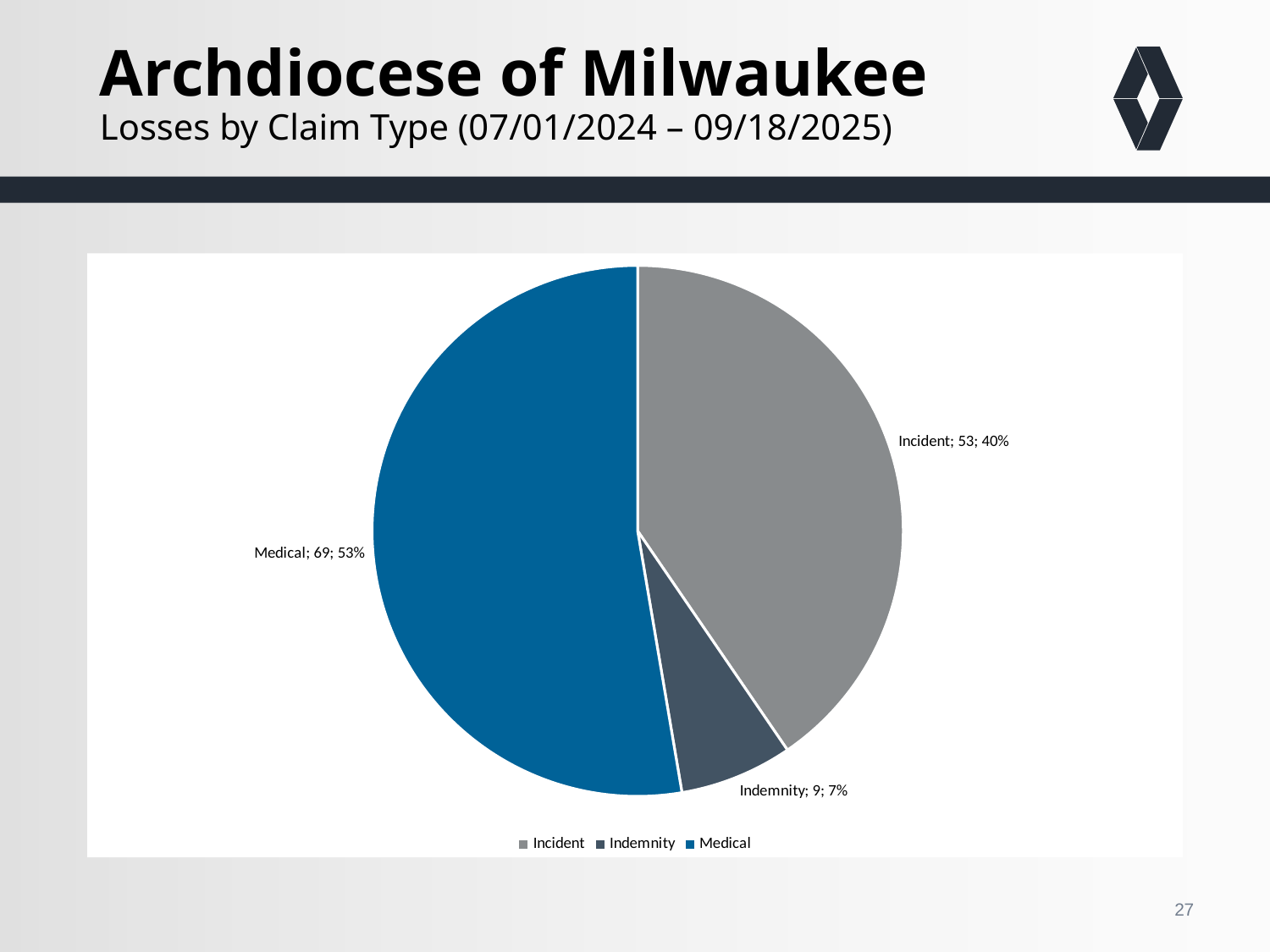
Which is larger, the value for Incident or the value for Indemnity? Incident Which claim type has the smallest slice? Indemnity What share of the pie does Medical represent? 53% What is the value for Incident? 53 What kind of chart is shown on the slide? pie chart What is the difference between the values for Medical and Incident? 16 What share of the pie does Indemnity represent? 7% Which claim type has the largest slice? Medical What is the value for Medical? 69 What is the value for Indemnity? 9 How many entries does the legend list? 3 How many slices does the pie chart have? 3